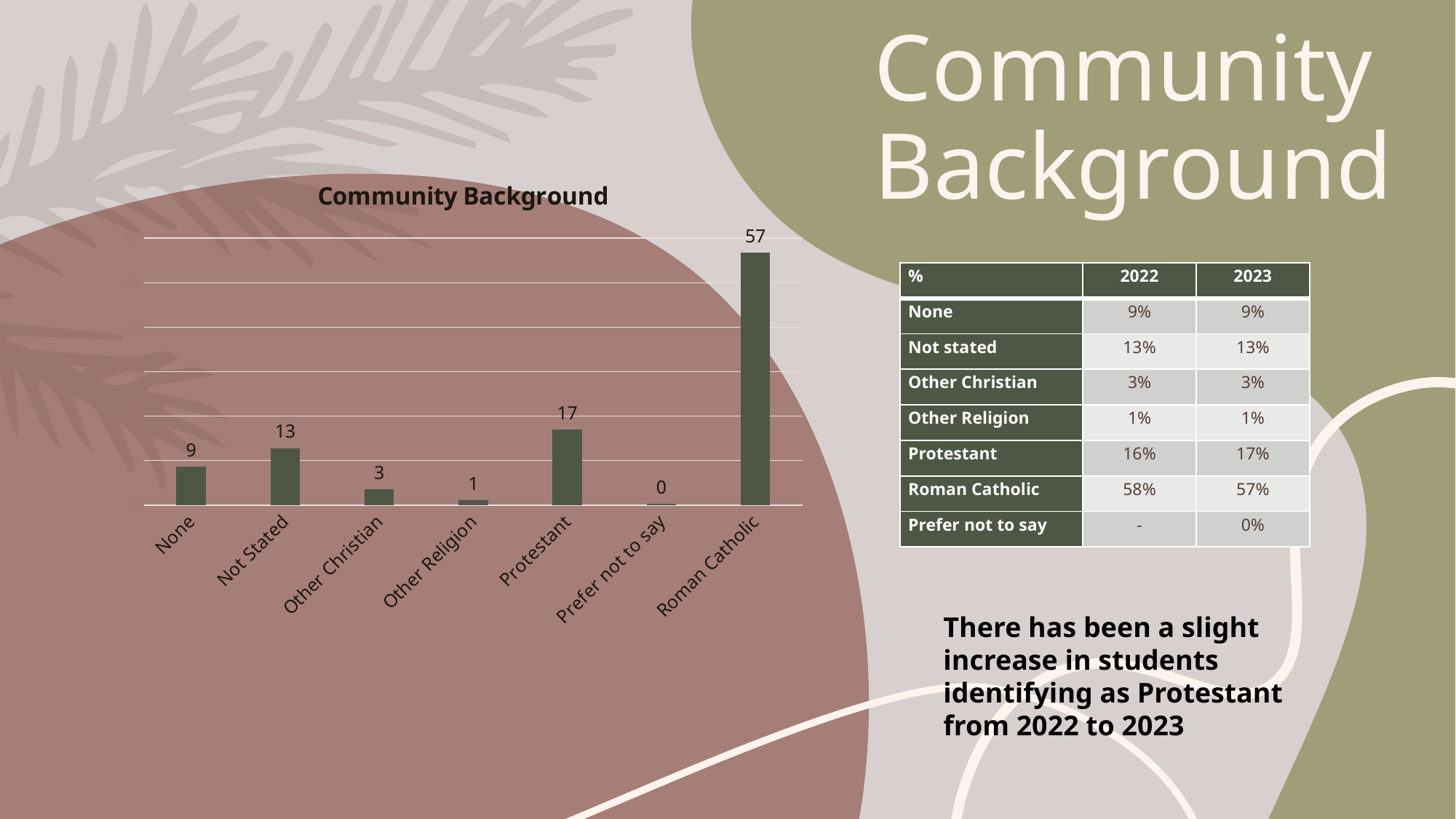
What is the difference between the values for Roman Catholic and Protestant in the Community Background chart? 40 What is the value for Other Religion in the Community Background chart? 1 What kind of chart is the Community Background chart? bar chart How many categories are shown in the Community Background chart? 7 Which category has the lowest value in the Community Background chart? Prefer not to say What is the value for Roman Catholic in the Community Background chart? 57 Which is larger in the Community Background chart, the value for None or the value for Not Stated? Not Stated What is the value for Protestant in the Community Background chart? 17 Is the value for Roman Catholic in the Community Background chart greater or less than 50? greater Which category has the highest value in the Community Background chart? Roman Catholic What is the value for Not Stated in the Community Background chart? 13 What is the title of the chart on the slide? Community Background